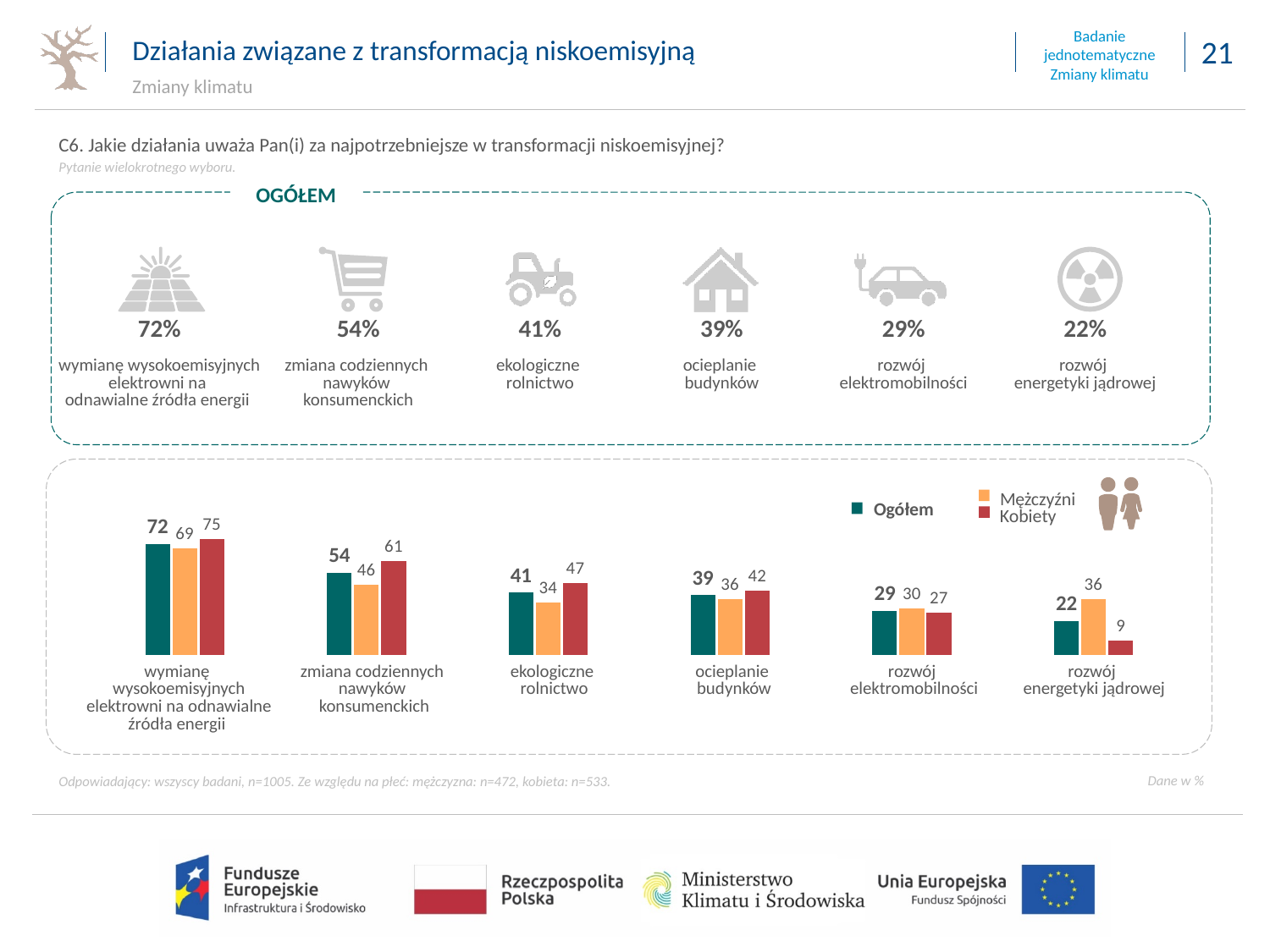
In the bar chart at the bottom of the slide, what is the value for Mężczyźni for 'zmiana codziennych nawyków konsumenckich'? 46 How many categories are shown in the bar chart at the bottom of the slide? 6 What kind of chart is shown at the bottom of the slide? bar chart In the bar chart at the bottom of the slide, what is the value for Kobiety for 'rozwój energetyki jądrowej'? 9 In the bar chart at the bottom of the slide, which series is shown in dark green? Ogółem In the bar chart at the bottom of the slide, which is larger for 'ocieplanie budynków': the Mężczyźni value or the Kobiety value? Kobiety In the bar chart at the bottom of the slide, what is the Ogółem value for 'ekologiczne rolnictwo'? 41 How many series does the legend of the bar chart at the bottom of the slide list? 3 In the top 'OGÓŁEM' infographic, what percentage is shown for 'rozwój elektromobilności'? 29% In the bar chart at the bottom of the slide, which category has the lowest Kobiety value? rozwój energetyki jądrowej In the bar chart at the bottom of the slide, what is the difference between the Mężczyźni and Kobiety values for 'rozwój energetyki jądrowej'? 27 In the bar chart at the bottom of the slide, which category has the highest Ogółem value? wymianę wysokoemisyjnych elektrowni na odnawialne źródła energii